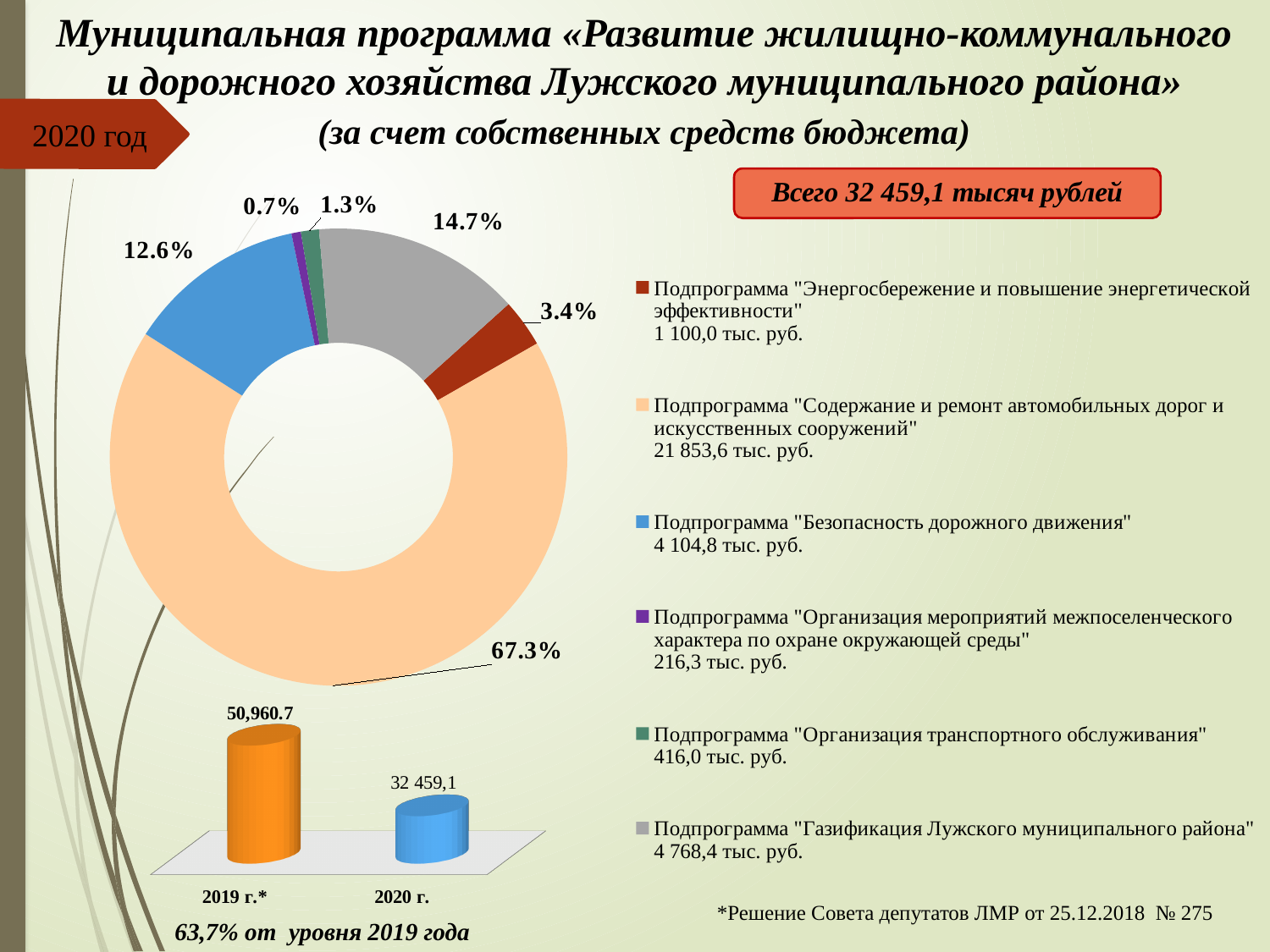
How many bars are shown in the bar chart at the bottom left? 2 In the doughnut chart, which subprogram has the smallest share? Организация мероприятий межпоселенческого характера по охране окружающей среды According to the legend of the doughnut chart, what is the amount for the subprogram "Энергосбережение и повышение энергетической эффективности"? 1 100,0 тыс. руб. In the bar chart at the bottom left, what is the value for 2019 г.*? 50,960.7 What kind of chart is the large chart on the left of the slide? Doughnut (pie) chart In the bar chart at the bottom left, what is the value for 2020 г.? 32 459,1 In the bar chart at the bottom left, which year has the larger value, 2019 г.* or 2020 г.? 2019 г.* In the doughnut chart, what share does the subprogram "Содержание и ремонт автомобильных дорог и искусственных сооружений" have? 67.3% How many subprograms (slices) are shown in the doughnut chart? 6 In the doughnut chart, what share does the subprogram "Газификация Лужского муниципального района" have? 14.7% According to the legend of the doughnut chart, what is the amount for the subprogram "Безопасность дорожного движения"? 4 104,8 тыс. руб. In the doughnut chart, which subprogram has the largest share? Содержание и ремонт автомобильных дорог и искусственных сооружений